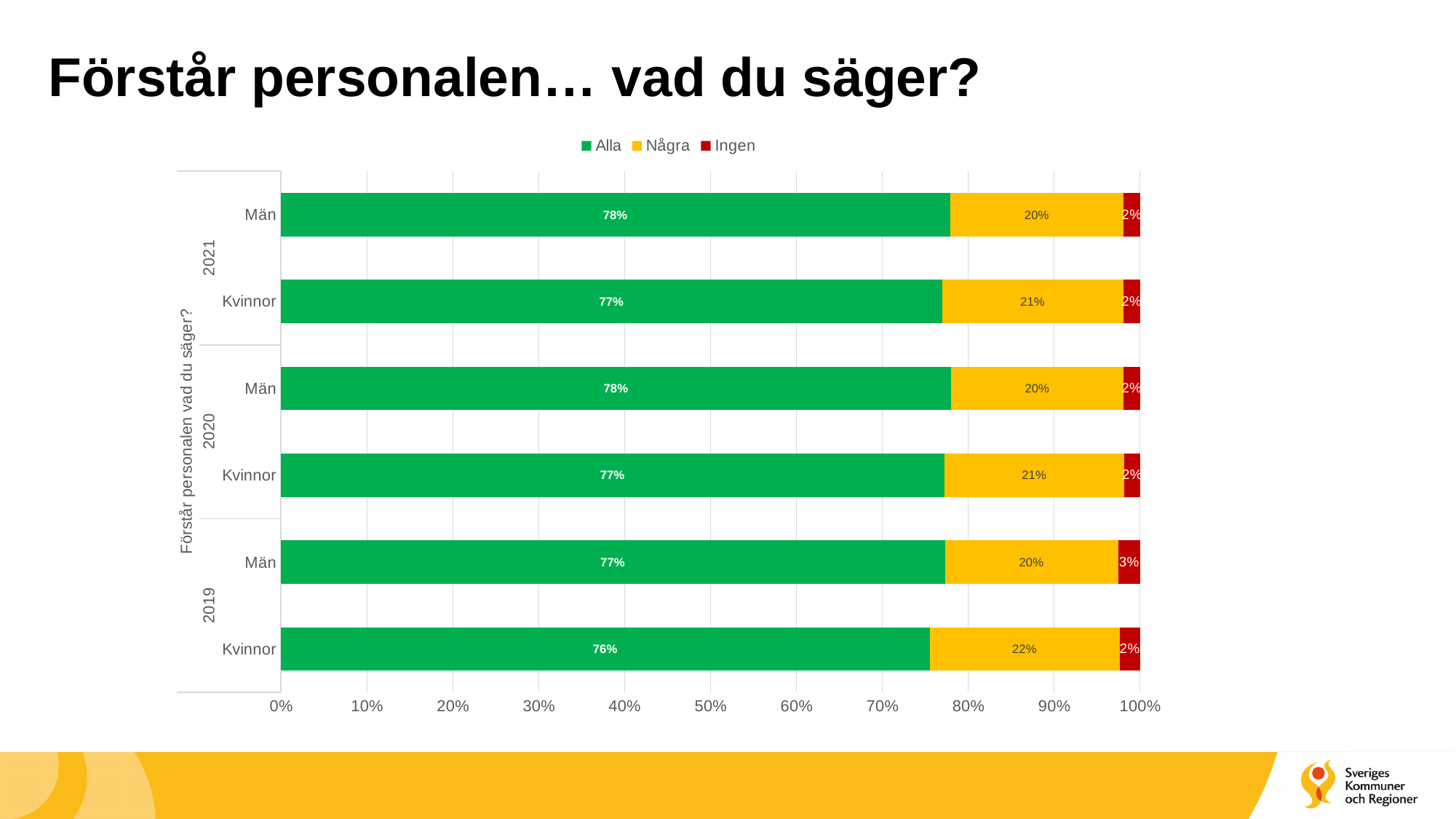
What is the difference between the Alla value for Män in 2021 and the Alla value for Kvinnor in 2019? 2% Which bar has the highest value for Ingen? Män 2019 What is the value for Några for Kvinnor in 2019? 22% What is the value for Ingen for Män in 2019? 3% How many series does the legend list? 3 Which bar has the lowest value for Alla? Kvinnor 2019 Which is larger: the Några value for Kvinnor in 2021 or the Några value for Män in 2021? Kvinnor 2021 Which series is shown in red in the legend? Ingen What is the value for Alla for Kvinnor in 2020? 77% What is the value for Alla for Män in 2021? 78% What kind of chart is shown on the slide? Stacked bar chart How many bars are plotted in the chart? 6